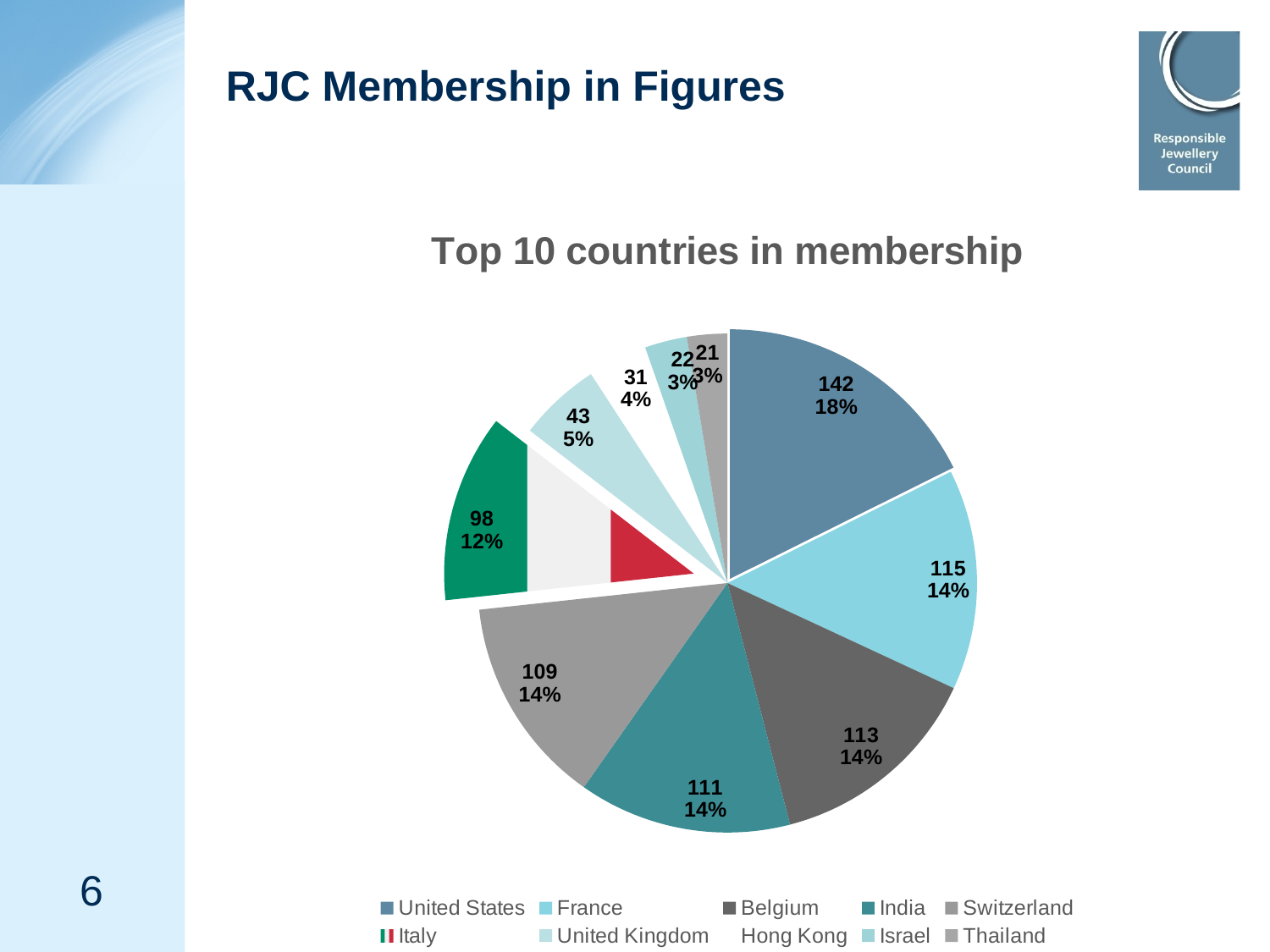
What is the membership value for Italy? 98 How many countries (slices) does the pie chart show? 10 Which country has the smallest slice of the pie? Thailand What is the title of the chart? Top 10 countries in membership What type of chart is shown on the slide? pie chart What is the membership value for the United Kingdom? 43 What is the membership value for the United States? 142 Which country has the largest slice of the pie? United States What is the difference between the values for the United States and France? 27 What percentage share of the pie does Hong Kong represent? 4% Which has a larger value, Italy or the United Kingdom? Italy What percentage share of the pie does the United States slice represent? 18%